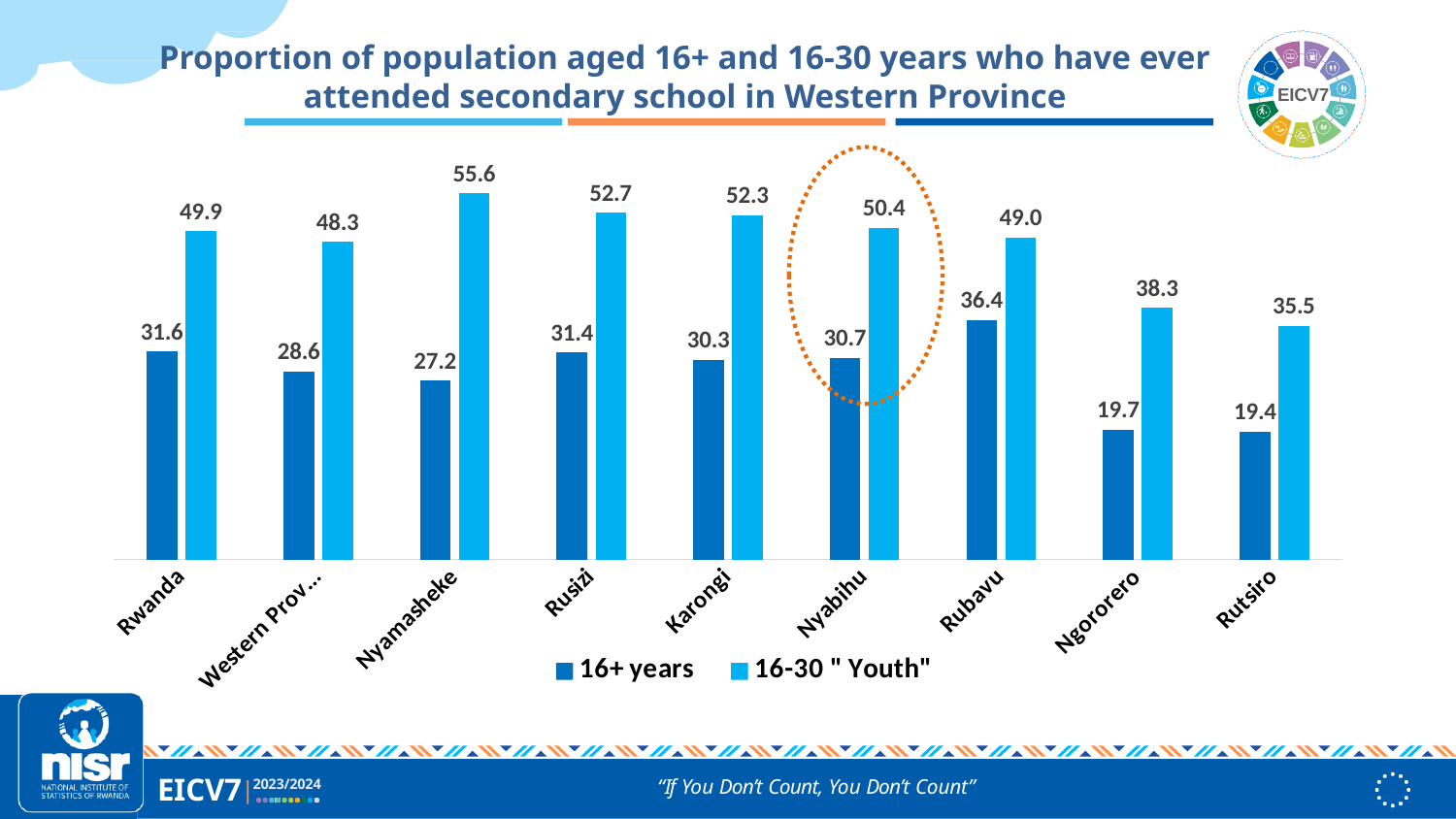
Which category has the highest value in the 16-30 "Youth" series? Nyamasheke What is the value for Nyamasheke in the 16-30 "Youth" series? 55.6 How many series does the legend list? 2 Which category has the lowest value in the 16-30 "Youth" series? Rutsiro What is the value for Rwanda in the 16+ years series? 31.6 What is the value for Rubavu in the 16+ years series? 36.4 What is the value for Nyabihu in the 16-30 "Youth" series? 50.4 What is the difference between the 16-30 "Youth" value and the 16+ years value for Ngororero? 18.6 Which category has the highest value in the 16+ years series? Rubavu How many categories are shown on the x axis? 9 What kind of chart is shown on the slide? Bar chart Which is larger: the 16+ years value for Rusizi or the 16+ years value for Karongi? Rusizi